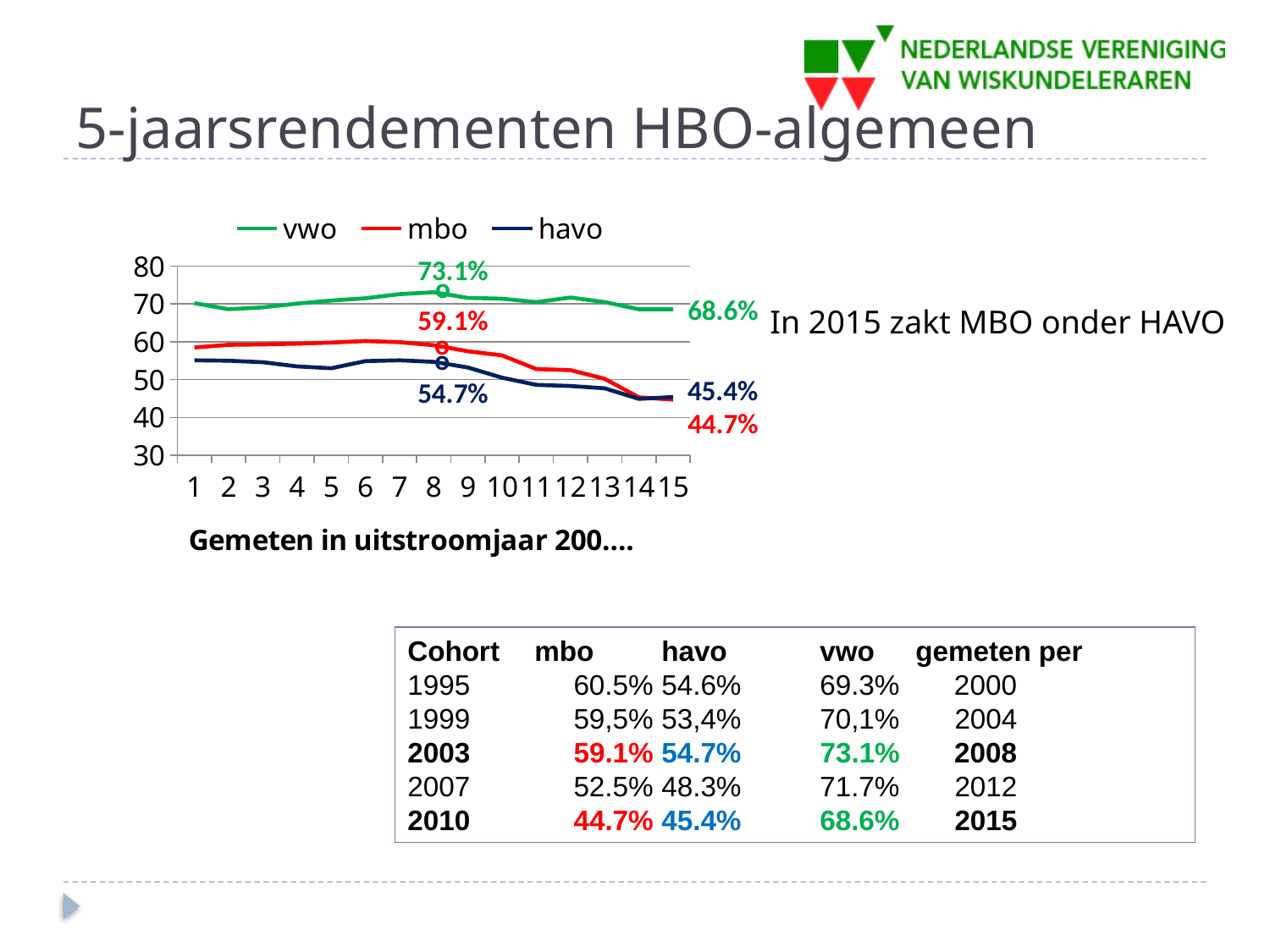
What is the labelled value for havo at point 15 on the chart? 45.4% How many points are plotted along the x axis of the chart? 15 Is the value for mbo at point 1 greater or less than 50? greater What is the difference between the vwo and havo values at point 8 on the chart? 18.4% Does the mbo line rise or fall from point 8 to point 15 on the chart? fall What kind of chart is shown on the slide? line chart What is the labelled value for vwo at point 8 on the chart? 73.1% At point 15, which is larger on the chart: the mbo value or the havo value? havo What is the labelled value for mbo at point 8 on the chart? 59.1% Which series has the highest value at point 15 on the chart? vwo Which series has the lowest value at point 8 on the chart? havo How many series does the chart's legend list? 3